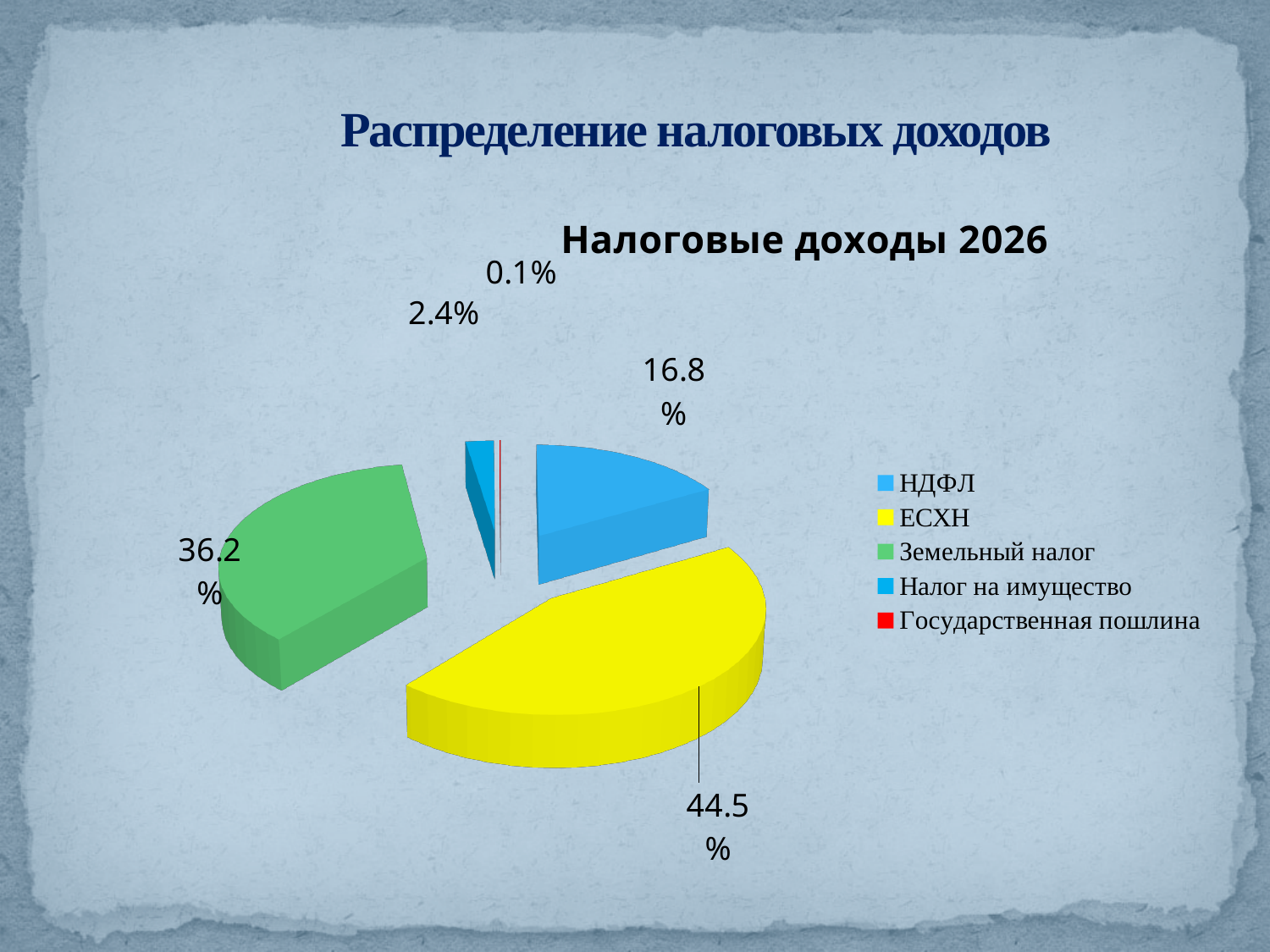
What share of the pie does НДФЛ have? 16.8% Which is larger, the share of НДФЛ or the share of Земельный налог? Земельный налог What is the difference between the shares of ЕСХН and Земельный налог? 8.3% What is the title of the chart? Налоговые доходы 2026 Which category has the largest share of the pie? ЕСХН What share of the pie does ЕСХН have? 44.5% How many categories does the legend list? 5 What share of the pie does Налог на имущество have? 2.4% What type of chart is shown on the slide? pie chart Which category has the smallest share of the pie? Государственная пошлина